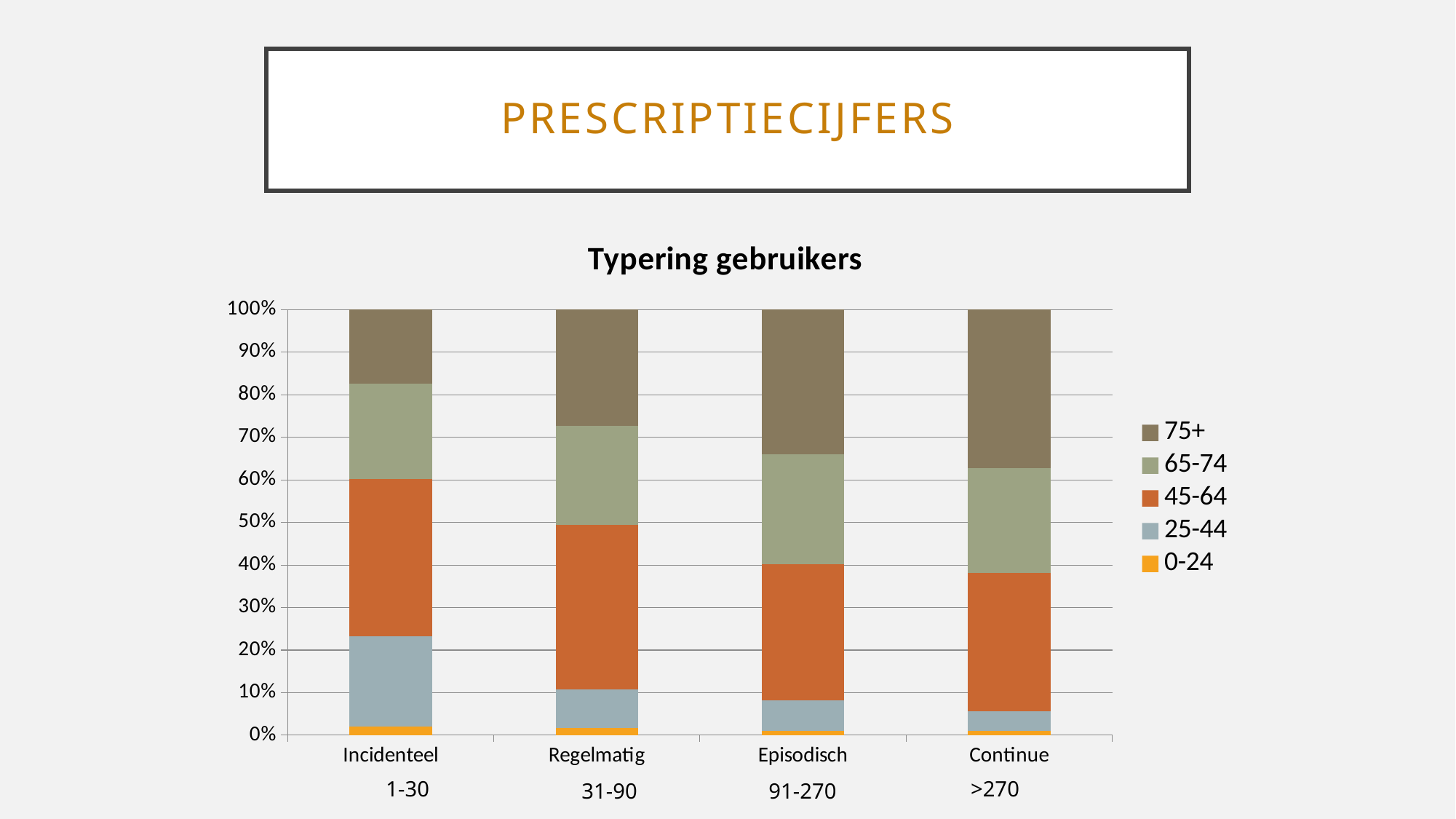
Is the 75+ segment for Continue greater or less than 30%? greater Which age group is shown in orange in the 'Typering gebruikers' chart? 45-64 Which category has the largest 75+ segment in the 'Typering gebruikers' chart? Continue How many series does the legend of the 'Typering gebruikers' chart list? 5 What kind of chart is shown under the title 'Typering gebruikers'? stacked bar chart How many categories are shown on the x axis of the 'Typering gebruikers' chart? 4 Is the 25-44 segment larger for Incidenteel or for Continue? Incidenteel Is the 25-44 segment for Incidenteel greater or less than 10%? greater What is the title of the chart on the slide? Typering gebruikers Does the share of the 75+ group rise or fall from Incidenteel to Continue along the x axis? rise Is the 75+ segment for Incidenteel greater or less than 20%? less Which category has the largest 25-44 segment in the 'Typering gebruikers' chart? Incidenteel